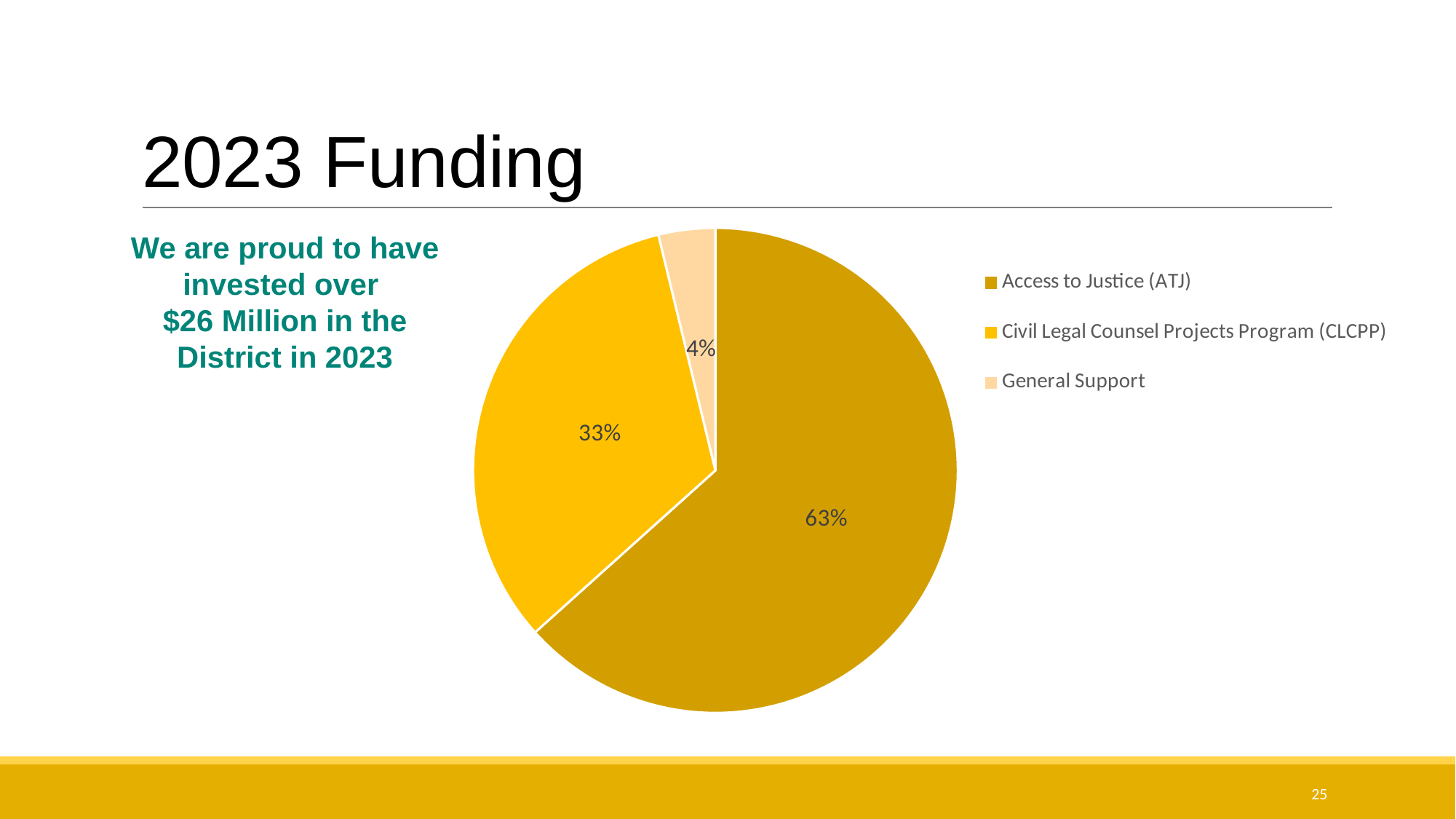
How many entries does the legend list? 3 What share of 2023 funding went to General Support? 4% Which category received the smallest share of 2023 funding? General Support What kind of chart is shown on the slide? pie chart What share of 2023 funding went to the Civil Legal Counsel Projects Program (CLCPP)? 33% Which legend entry is shown in the lightest colour? General Support Which is larger: the share for Civil Legal Counsel Projects Program (CLCPP) or the share for General Support? Civil Legal Counsel Projects Program (CLCPP) How many percentage points larger is the CLCPP share than the General Support share? 29 percentage points How many percentage points larger is the Access to Justice (ATJ) share than the Civil Legal Counsel Projects Program (CLCPP) share? 30 percentage points How many slices does the pie chart have? 3 Which category received the largest share of 2023 funding? Access to Justice (ATJ) What share of 2023 funding went to Access to Justice (ATJ)? 63%